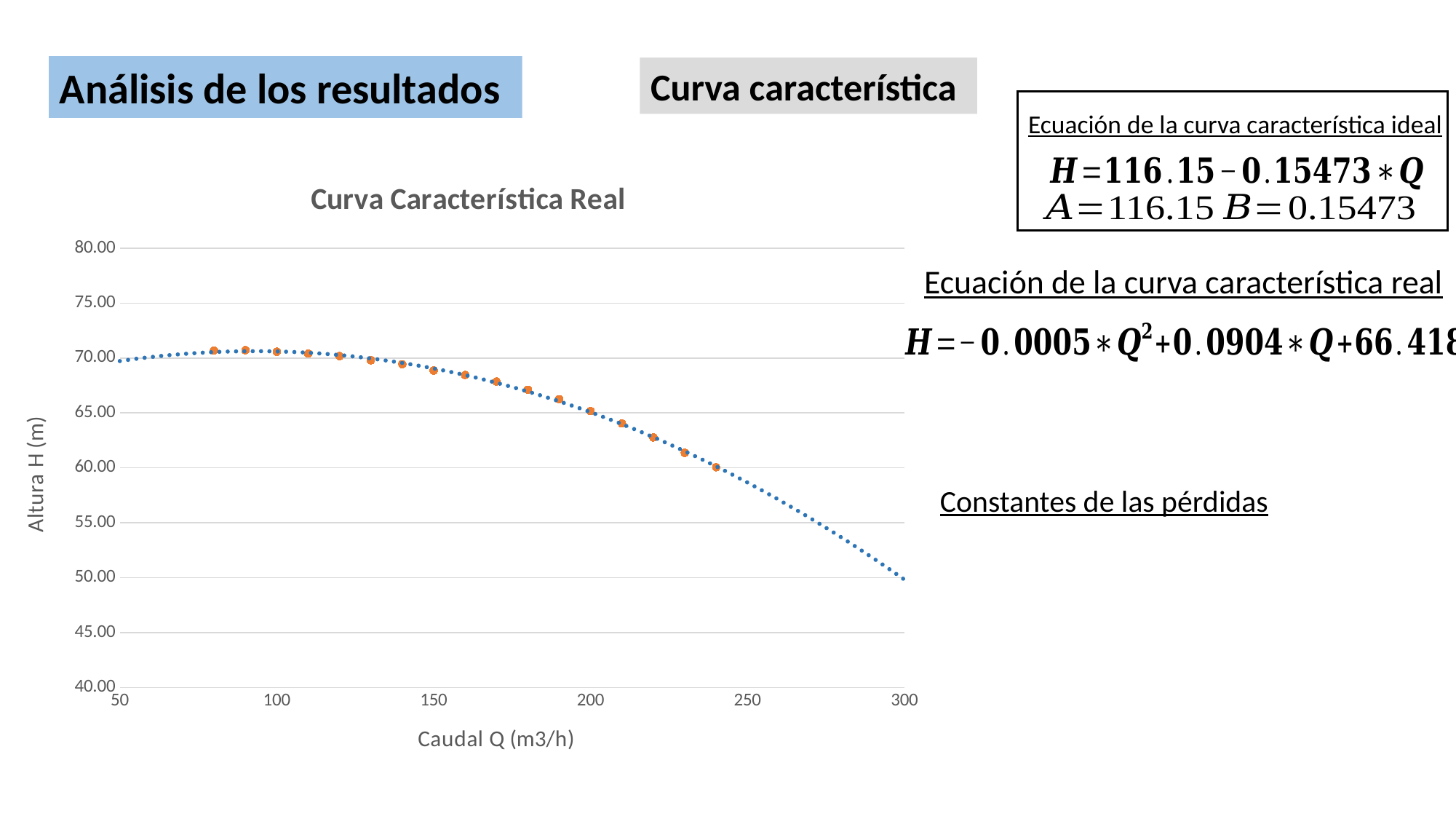
What kind of chart is shown on the slide? scatter chart Is the value of Altura H at Caudal Q = 180 greater or less than 65? greater What is the title of the chart? Curva Característica Real How many data points are plotted in the chart? 17 Is the value of Altura H at Caudal Q = 160 greater or less than 70? less Which is larger, the Altura H value at Caudal Q = 100 or at Caudal Q = 200? Caudal Q = 100 Is the value of Altura H at Caudal Q = 220 greater or less than 60? greater What is the label of the x axis of the chart? Caudal Q (m3/h) Do the plotted values of Altura H rise or fall as Caudal Q increases along the x axis? fall Which plotted point has the lowest Altura H value, the one at Caudal Q = 240 or the one at Caudal Q = 80? Caudal Q = 240